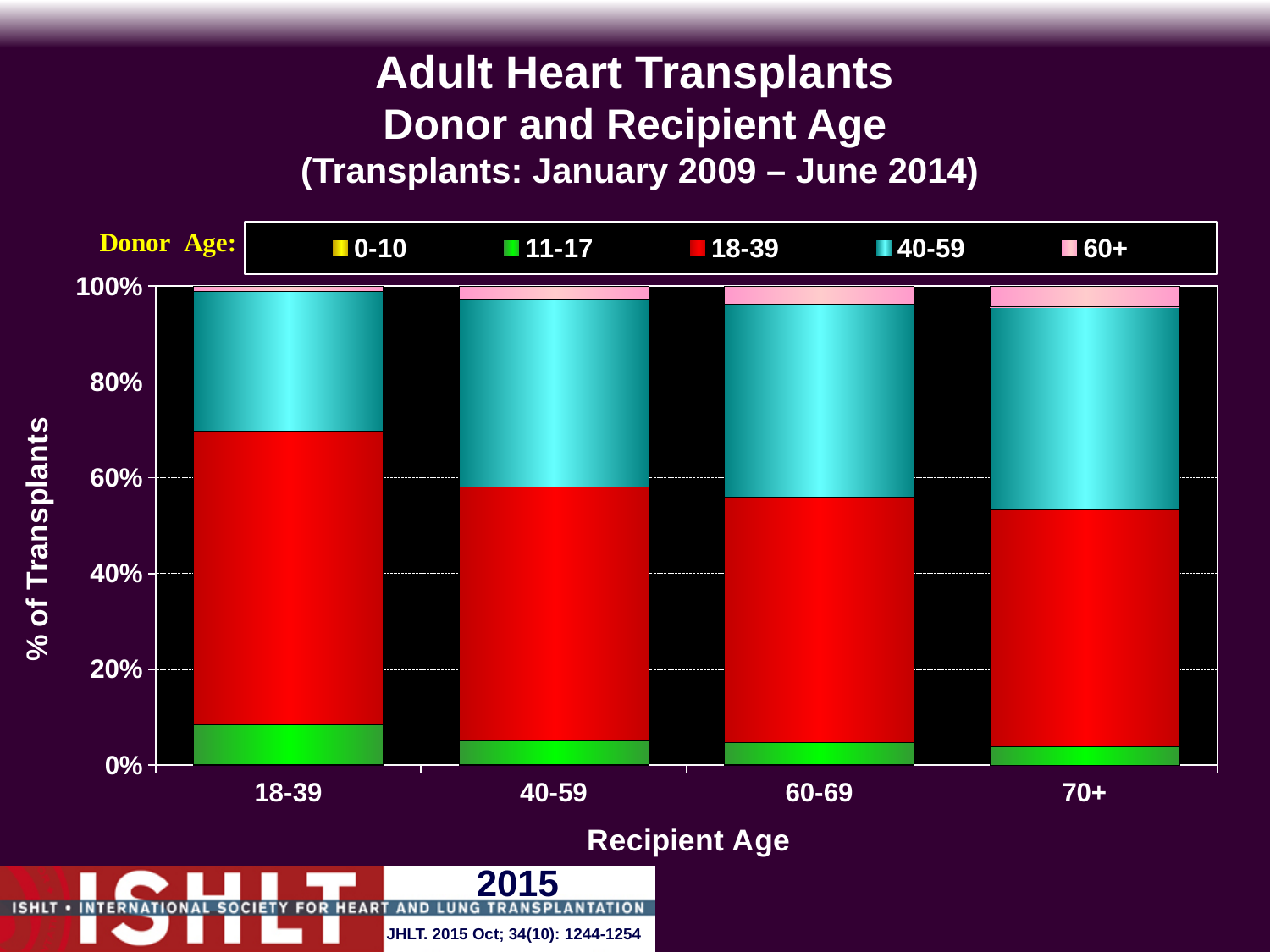
Is the share of 11-17 donors for recipients aged 18-39 greater or less than 20%? less Which recipient age group has the larger share of 11-17 donors, 18-39 or 70+? 18-39 What is the label of the y axis? % of Transplants Does the share of 18-39 donors rise or fall as recipient age increases along the x axis? fall What kind of chart is shown on the slide? Stacked bar chart Does the share of 60+ donors rise or fall as recipient age increases along the x axis? rise Is the share of 18-39 donors for recipients aged 70+ greater or less than 40%? greater Which recipient age group has the largest share of 18-39 donors? 18-39 How many donor age series does the legend list? 5 What is the title of the chart? Adult Heart Transplants Donor and Recipient Age (Transplants: January 2009 – June 2014) How many recipient age categories are shown on the x axis? 4 Is the share of 40-59 donors for recipients aged 18-39 greater or less than 40%? less